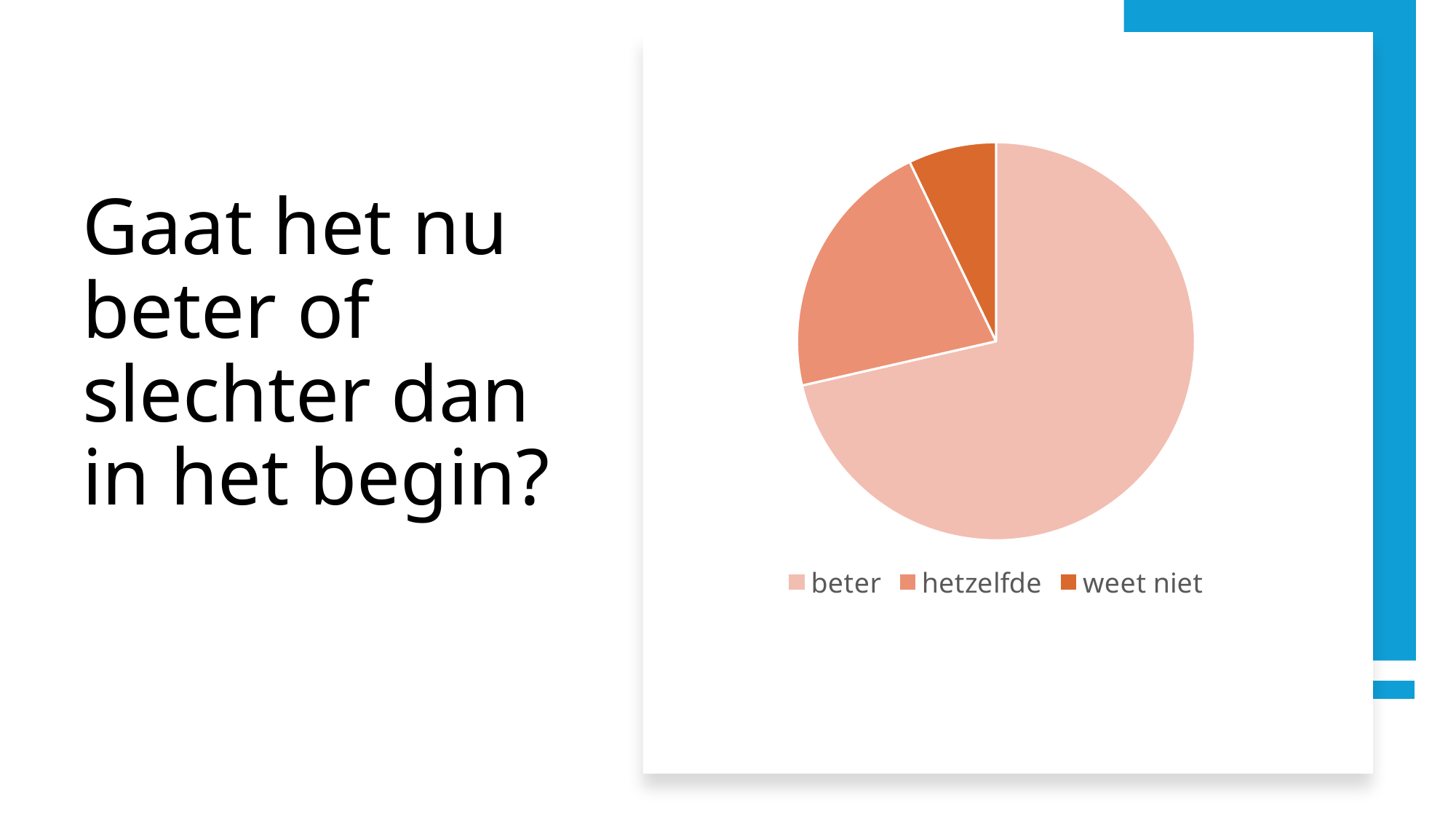
Does the beter slice take up more or less than half of the pie chart? more How many entries does the legend of the pie chart list? 3 Which slice is larger in the pie chart, beter or hetzelfde? beter Which category has the largest slice in the pie chart? beter Which slice is larger in the pie chart, hetzelfde or weet niet? hetzelfde Which legend entry is shown in the darkest orange colour in the pie chart? weet niet What kind of chart is shown on the slide? pie chart What are the legend entries of the pie chart, in order from left to right? beter, hetzelfde, weet niet How many slices does the pie chart have? 3 Which category has the smallest slice in the pie chart? weet niet